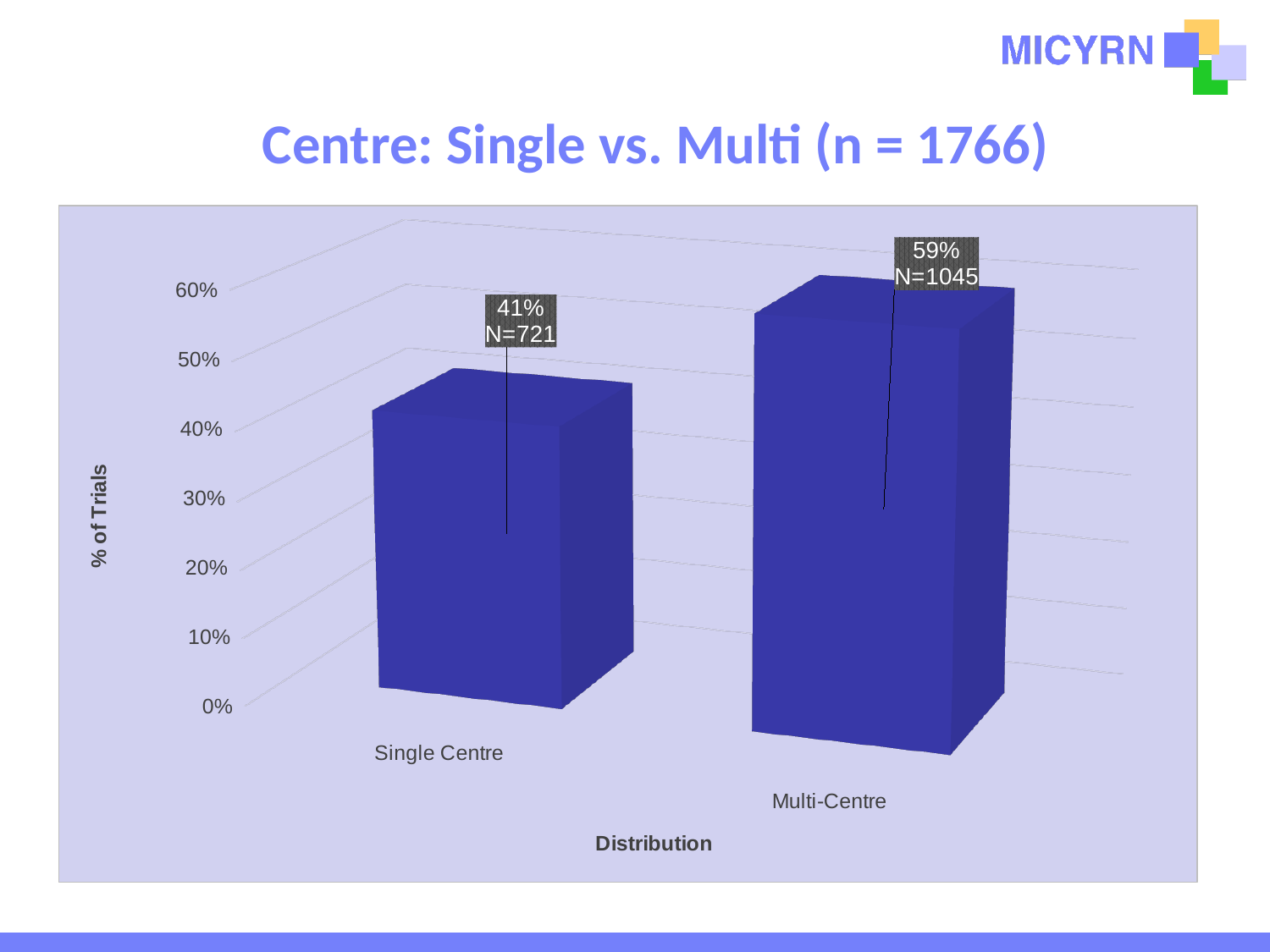
What kind of chart is shown on the slide? Bar chart What percentage of trials are Single Centre? 41% How many categories are shown on the x axis? 2 What is the difference in percentage points between Multi-Centre and Single Centre trials? 18% What is the title of the chart? Centre: Single vs. Multi (n = 1766) What is the N value shown for Multi-Centre trials? N=1045 Which category has the higher percentage of trials? Multi-Centre What percentage of trials are Multi-Centre? 59% What is the N value shown for Single Centre trials? N=721 Is the value for Single Centre greater or less than 50%? less What is the label of the y axis? % of Trials Which category has the lower percentage of trials? Single Centre